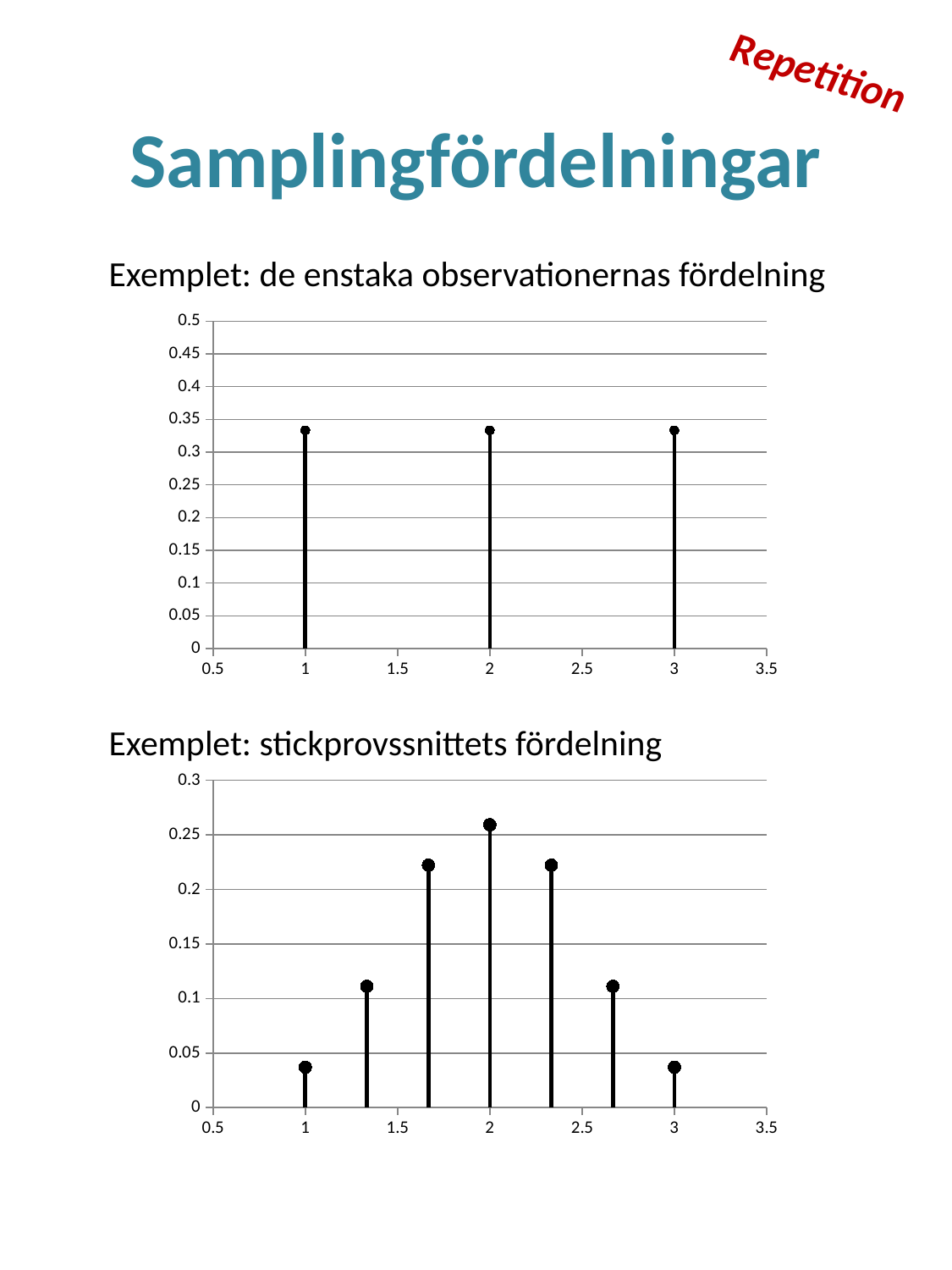
In the bottom chart, at which x value is the plotted value highest? 2 In the top chart, is the value at x = 2 greater or less than 0.35? less How many points are plotted in the top chart, 'Exemplet: de enstaka observationernas fördelning'? 3 In the bottom chart, is the value at x = 3 greater or less than 0.05? less In the bottom chart, which is larger: the value at x = 2 or the value at x = 1? the value at x = 2 In the top chart, do the plotted values rise, fall or stay the same as x increases from 1 to 3? stay the same In the bottom chart, do the plotted values rise or fall as x increases from 1 to 2? rise How many points are plotted in the bottom chart, 'Exemplet: stickprovssnittets fördelning'? 7 In the top chart, is the value at x = 1 greater or less than 0.3? greater What is the highest value shown on the y axis of the bottom chart? 0.3